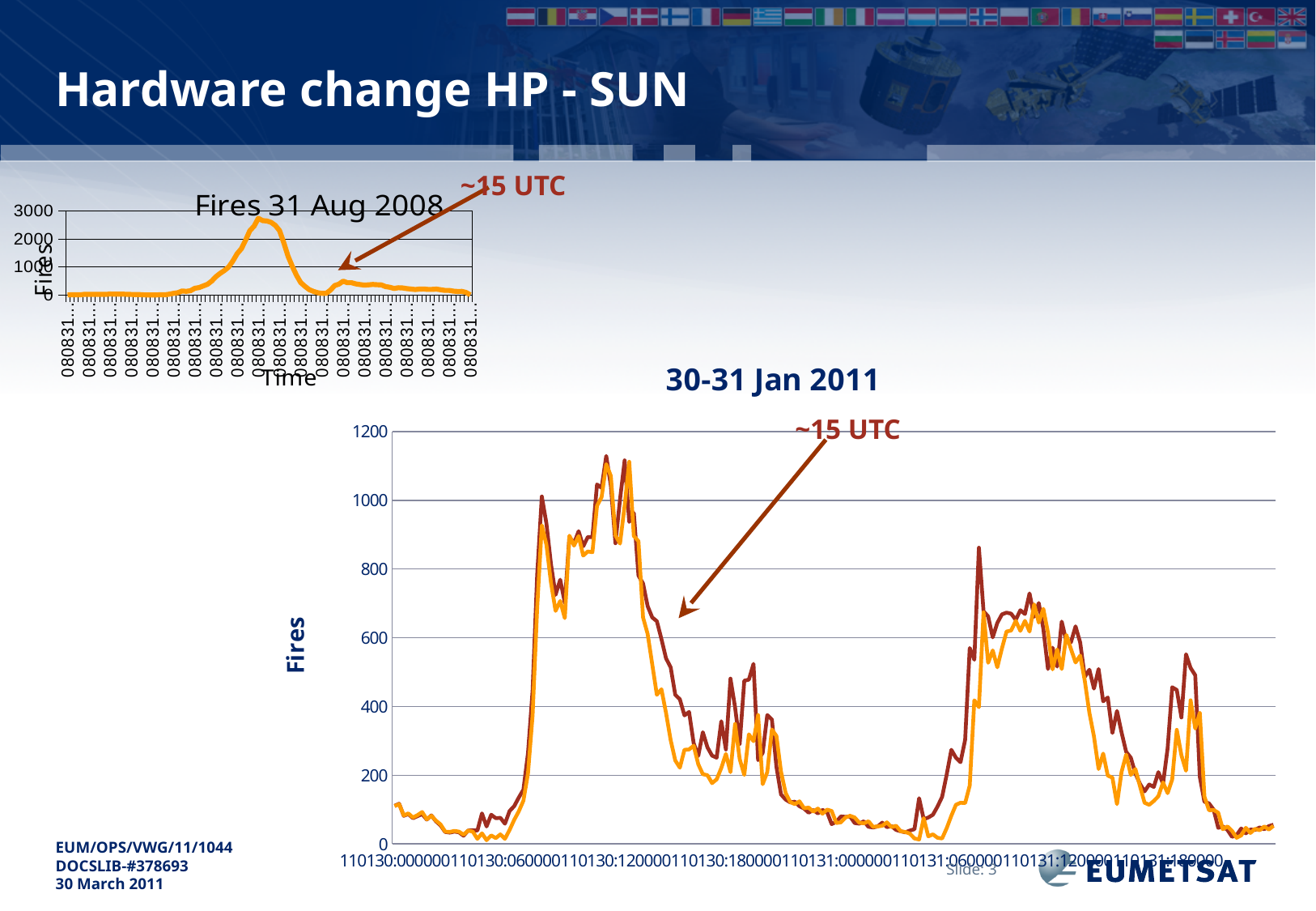
In the 'Fires 31 Aug 2008' chart, is the peak value greater or less than 2000? greater In the '30-31 Jan 2011' chart, is the highest peak greater or less than 1000? greater How many data series are plotted in the '30-31 Jan 2011' chart? 2 In the 'Fires 31 Aug 2008' chart, do the values rise or fall from the peak to the end of the x axis? fall What kind of chart is the 'Fires 31 Aug 2008' chart? line chart In the '30-31 Jan 2011' chart, is the value at the first time point greater or less than 200? less What is the y-axis label of the 'Fires 31 Aug 2008' chart? Fires What kind of chart is the '30-31 Jan 2011' chart? line chart What is the highest value shown on the y axis of the '30-31 Jan 2011' chart? 1200